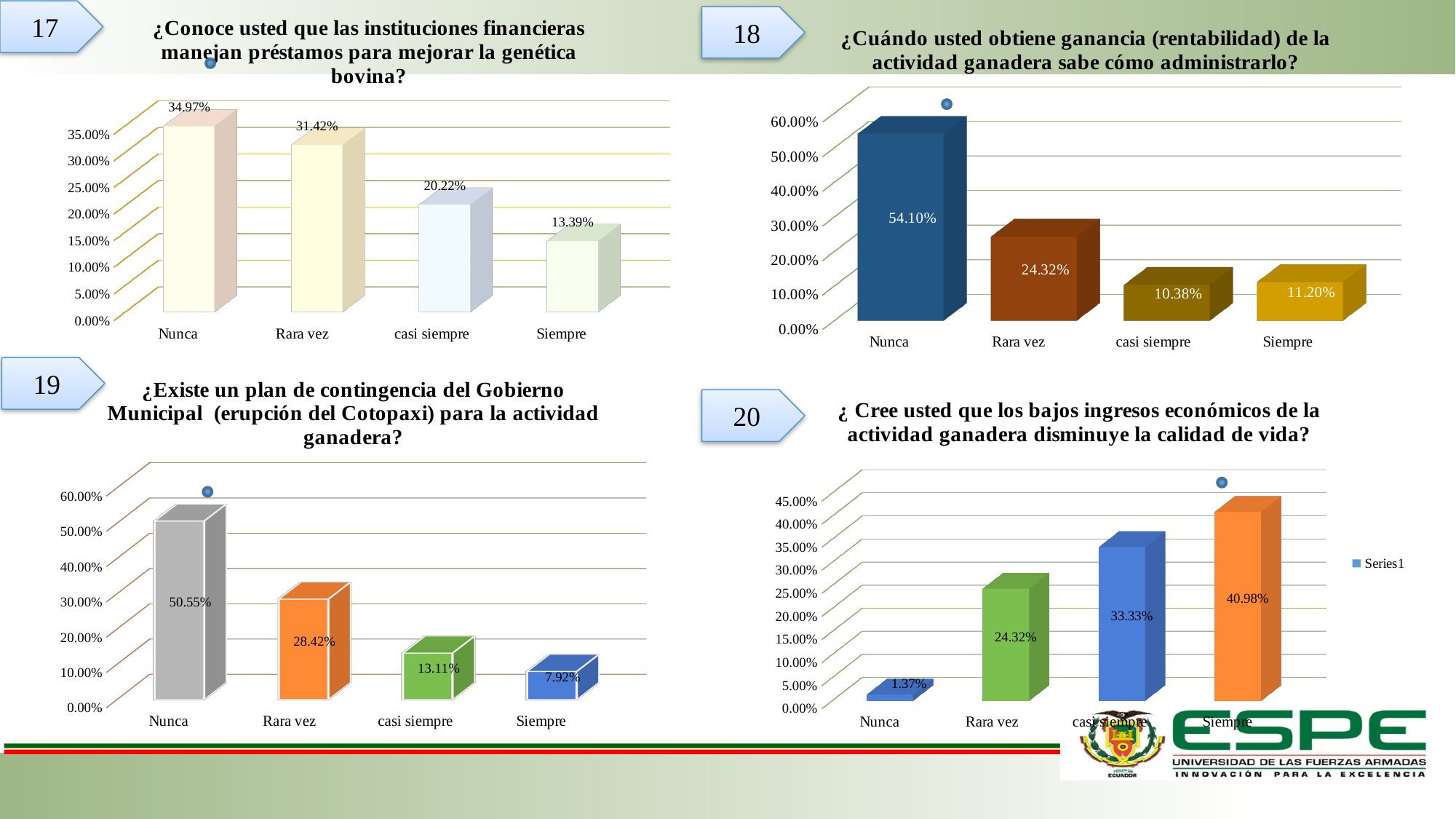
In the bottom-left chart (question 19), which category has the highest value? Nunca In the bottom-right chart (question 20), which category has the lowest value? Nunca In the bottom-left chart (question 19), what is the value for Siempre? 7.92% In the top-left chart (question 17), what is the value for Nunca? 34.97% In the top-right chart (question 18), what is the value for Rara vez? 24.32% What kind of chart is the top-left chart (question 17)? Bar chart In the bottom-left chart (question 19), what is the difference between the values for Rara vez and casi siempre? 15.31% How many categories are shown on the x axis of the bottom-right chart (question 20)? 4 What legend entry is shown on the bottom-right chart (question 20)? Series1 In the top-right chart (question 18), which is larger, the value for casi siempre or the value for Siempre? Siempre In the top-right chart (question 18), what is the difference between the values for Nunca and Rara vez? 29.78% In the bottom-right chart (question 20), do the values rise or fall from Nunca to Siempre? Rise